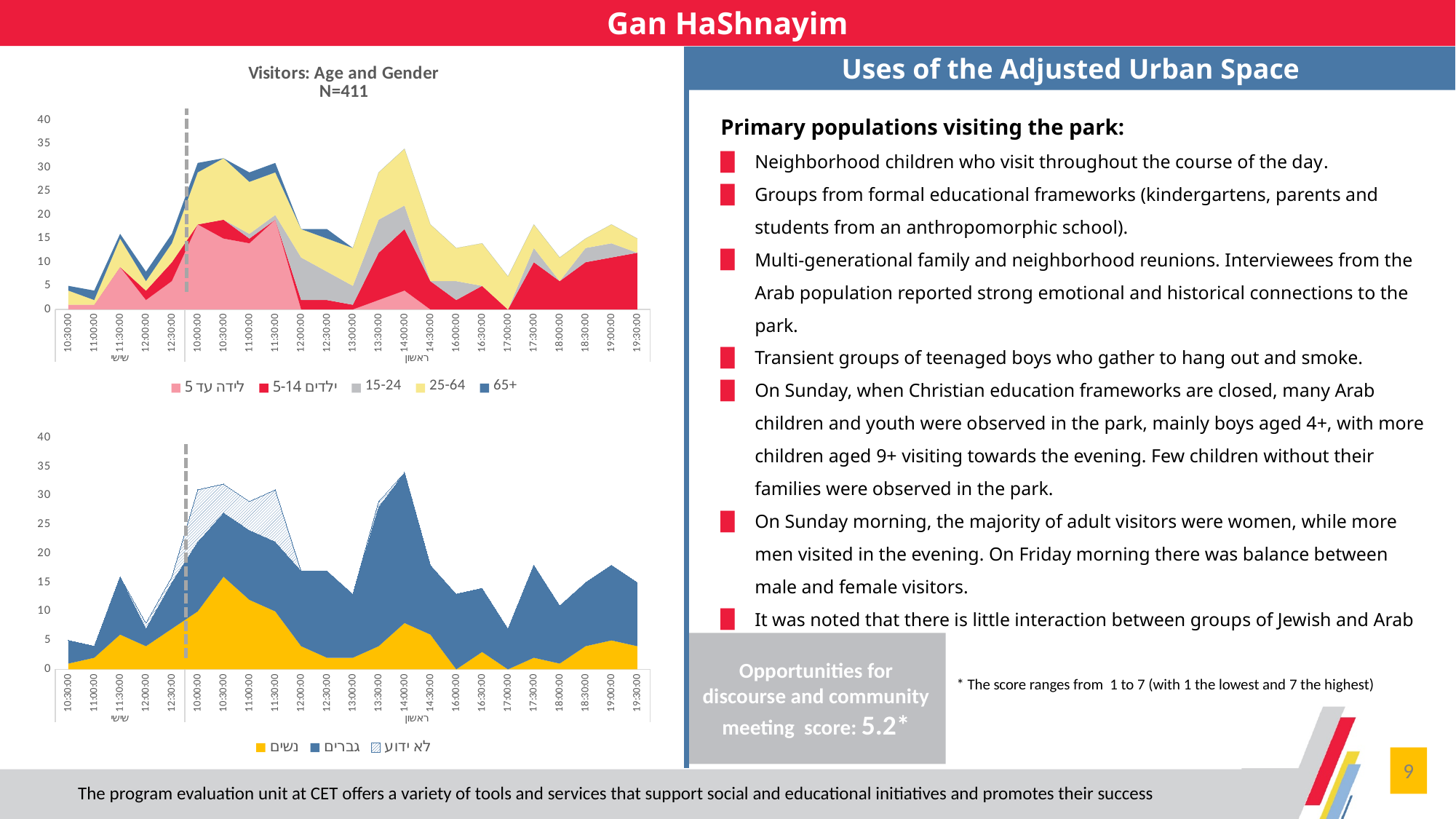
What kind of chart is the top chart titled "Visitors: Age and Gender N=411"? stacked area chart In the bottom chart, at which time point does the stacked total reach its highest value? 14:00:00 How many time points are plotted along the x axis of the top chart (Visitors: Age and Gender)? 23 In the bottom chart, is the stacked total at 17:00:00 greater or less than 10? less What is the maximum value shown on the vertical axis of the bottom chart? 40 In the top chart (Visitors: Age and Gender), is the stacked total at 14:00:00 greater or less than 30? greater What is the sample size (N) stated in the title of the top chart? N=411 How many series does the legend of the bottom chart list? 3 In the top chart (Visitors: Age and Gender), which age group is shown in yellow according to the legend? 25-64 In the top chart (Visitors: Age and Gender), is the stacked total at the first time point (10:30:00 on Friday) greater or less than 10? less In the top chart (Visitors: Age and Gender), at which time point does the stacked total reach its highest value? 14:00:00 How many series does the legend of the top chart (Visitors: Age and Gender) list? 5